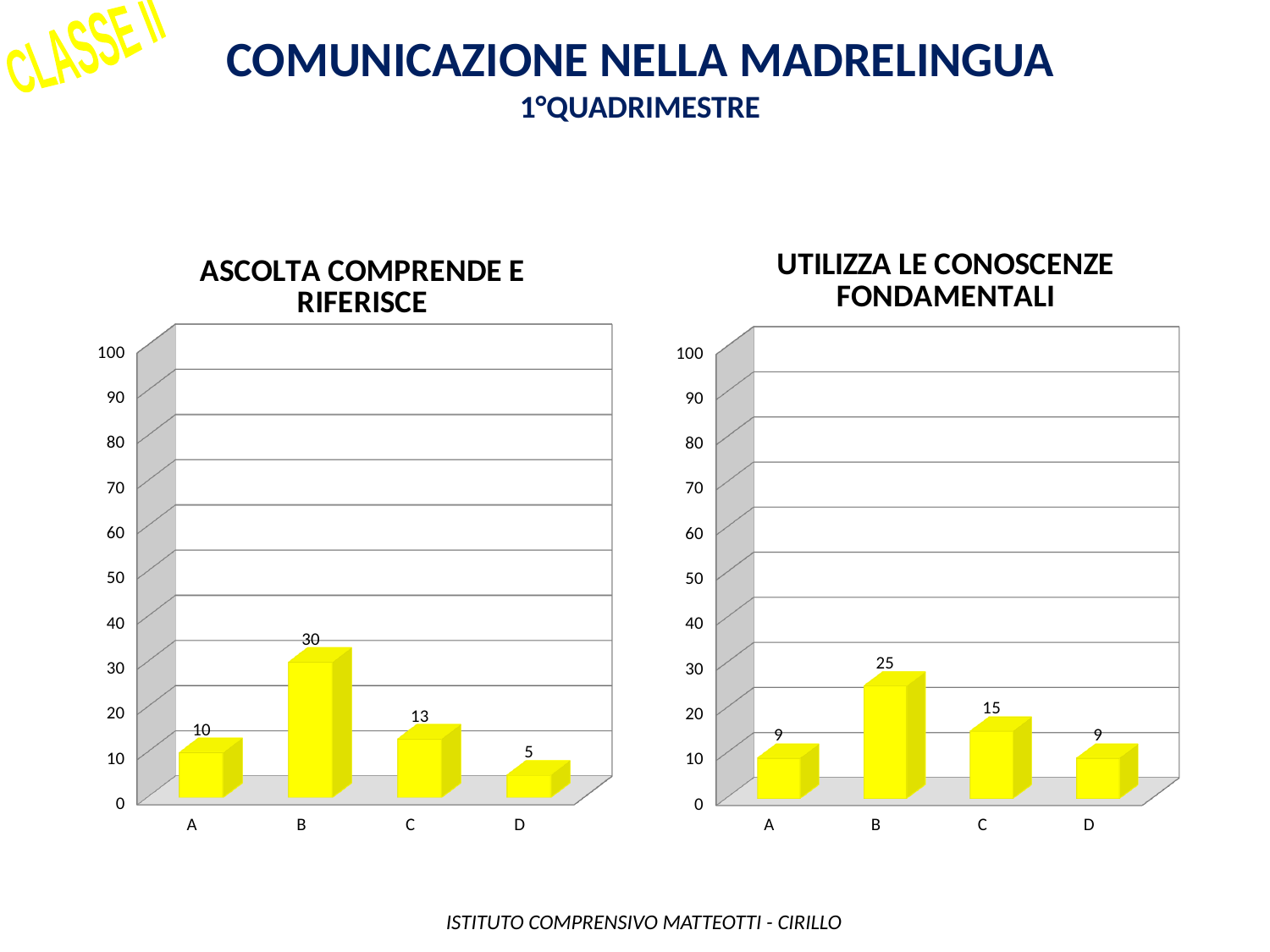
In the 'ASCOLTA COMPRENDE E RIFERISCE' chart, what is the value for category D? 5 In the 'ASCOLTA COMPRENDE E RIFERISCE' chart, which category has the lowest value? D How many categories are shown in the 'UTILIZZA LE CONOSCENZE FONDAMENTALI' chart? 4 In the 'UTILIZZA LE CONOSCENZE FONDAMENTALI' chart, what is the value for category C? 15 In the 'ASCOLTA COMPRENDE E RIFERISCE' chart, what is the difference between the values for B and C? 17 In the 'ASCOLTA COMPRENDE E RIFERISCE' chart, what is the value for category B? 30 In the 'UTILIZZA LE CONOSCENZE FONDAMENTALI' chart, what is the difference between the values for B and A? 16 What kind of chart is the 'ASCOLTA COMPRENDE E RIFERISCE' chart? Bar chart What is the title of the chart on the right side of the slide? UTILIZZA LE CONOSCENZE FONDAMENTALI In the 'ASCOLTA COMPRENDE E RIFERISCE' chart, is the value for B greater or less than 20? greater In the 'UTILIZZA LE CONOSCENZE FONDAMENTALI' chart, which category has the highest value? B In the 'UTILIZZA LE CONOSCENZE FONDAMENTALI' chart, which is larger, the value for C or the value for D? C